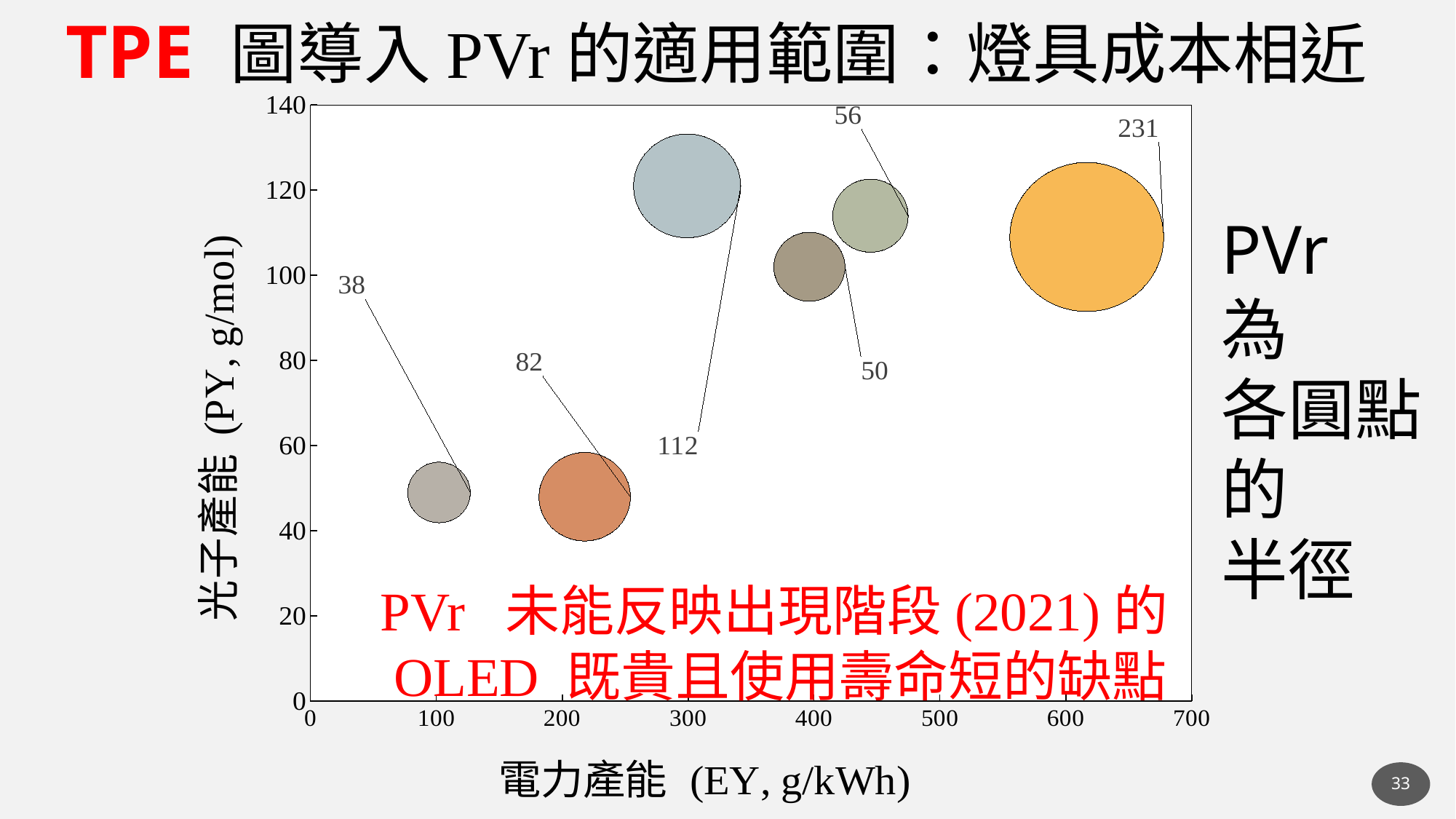
Is the 電力產能 (EY) value of the bubble labeled 231 greater or less than 600? greater Which is larger, the PVr label of the light blue bubble (112) or the orange-brown bubble (82)? 112 What kind of chart is shown on the slide? bubble chart Which bubble has the largest PVr label value? 231 Which bubble has the smallest PVr label value? 38 How many bubbles (data points) are plotted in the chart? 6 Is the 電力產能 (EY) value of the bubble labeled 38 greater or less than 200? less What is the title of the x axis? 電力產能 (EY, g/kWh) Is the 光子產能 (PY) value of the bubble labeled 38 greater or less than 60? less What is the difference between the largest PVr label (231) and the smallest PVr label (38)? 193 According to the slide, what does the radius of each bubble represent? PVr